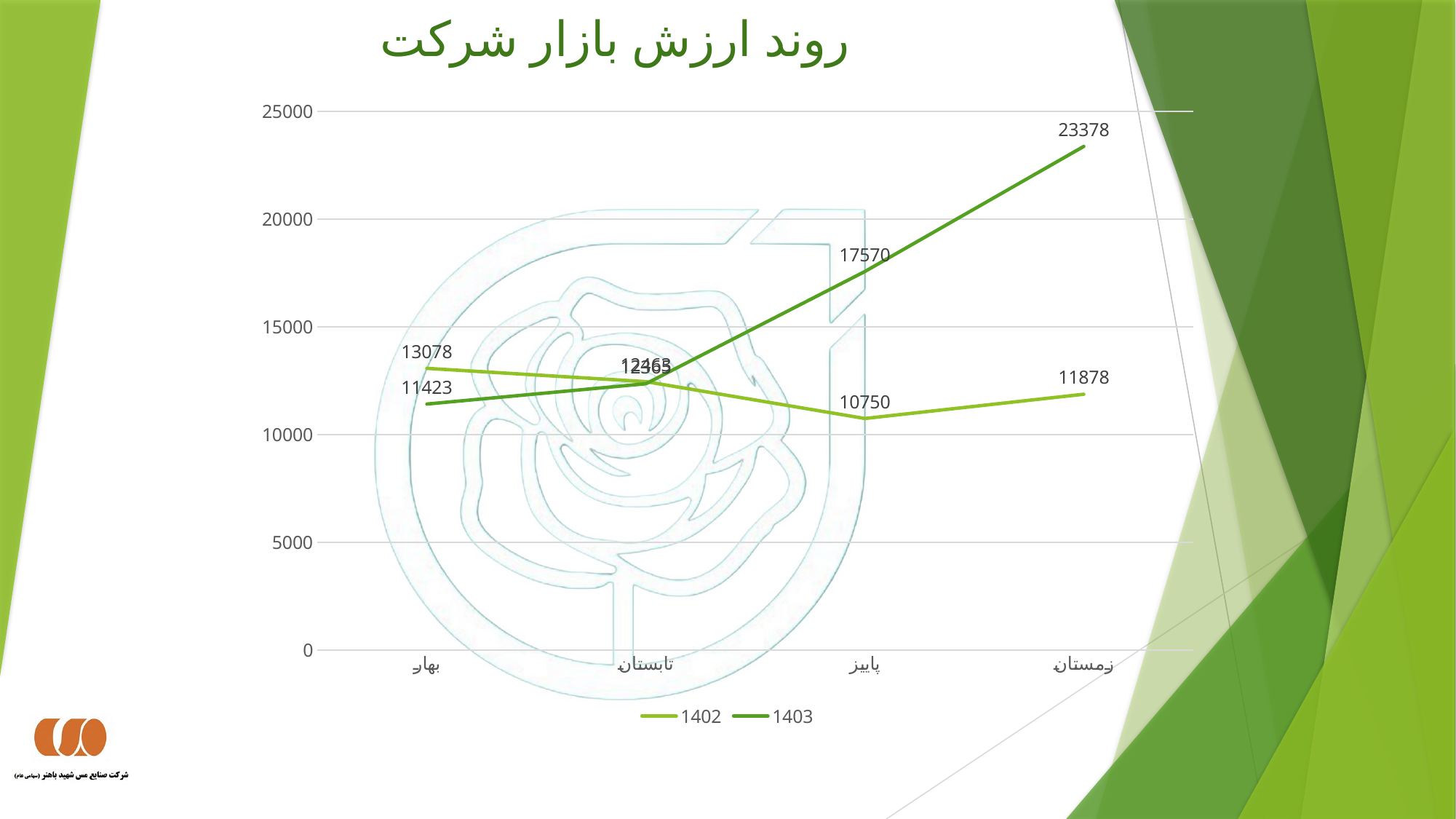
What is the difference between series 1403 and series 1402 for زمستان? 11500 What is the value of series 1403 for بهار? 11423 How many series does the legend list? 2 What is the value of series 1403 for زمستان? 23378 In which category does series 1403 reach its highest value? زمستان How many categories are on the x axis? 4 In which category does series 1402 have its lowest value? پاییز What is the value of series 1402 for پاییز? 10750 Does series 1403 rise or fall from بهار to زمستان? rise What is the value of series 1402 for بهار? 13078 What is the value of series 1403 for پاییز? 17570 What kind of chart is shown on the slide? line chart